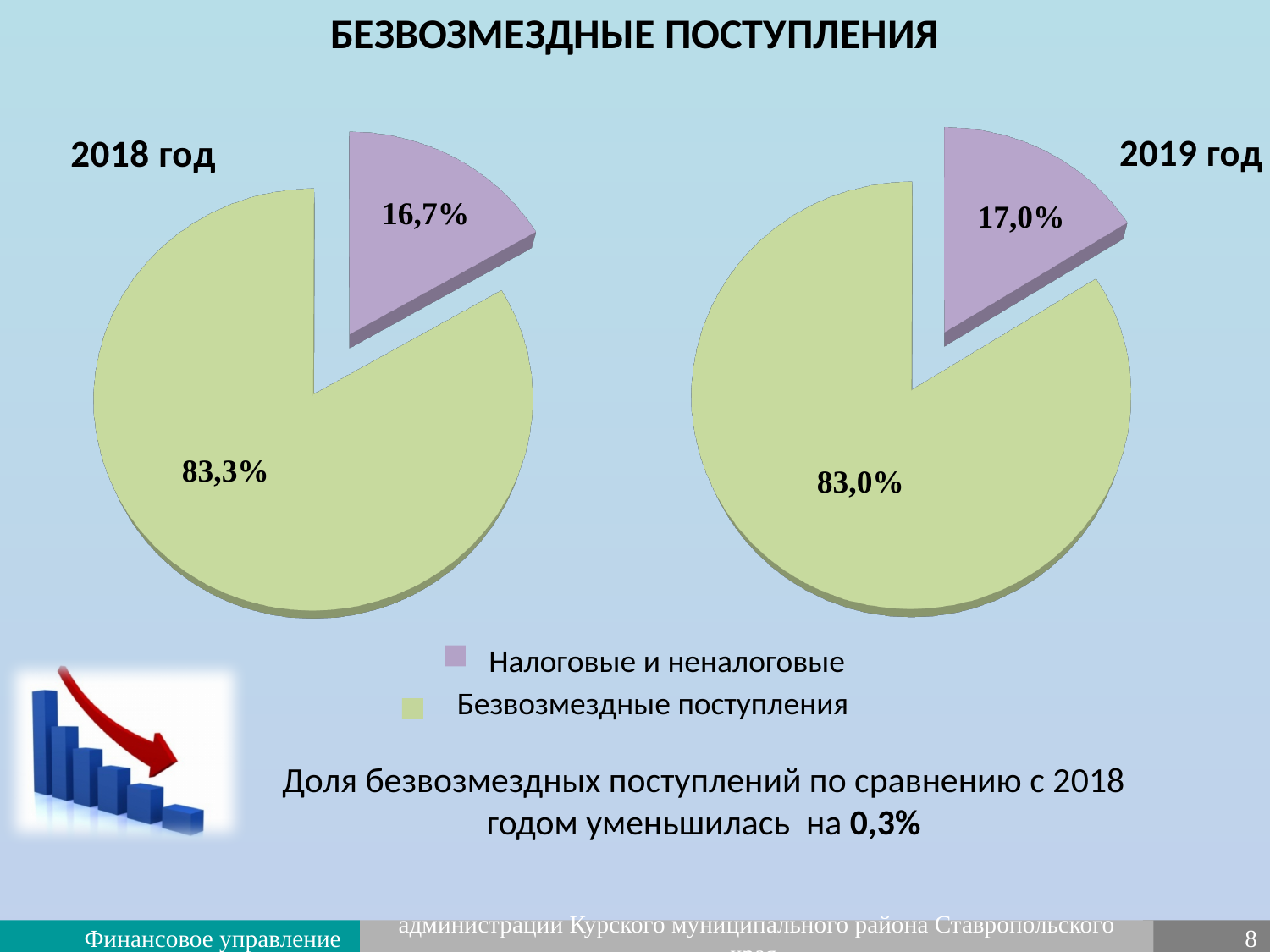
How many slices does the 2018 год pie chart have? 2 What colour represents Безвозмездные поступления in the pie charts? Light green In the 2019 год pie chart, what share is shown for Налоговые и неналоговые? 17,0% In the 2019 год pie chart, which category has the largest slice? Безвозмездные поступления Is the Налоговые и неналоговые share larger in the 2018 год chart or the 2019 год chart? 2019 год What is the difference between the Безвозмездные поступления share in the 2018 год chart and in the 2019 год chart? 0,3% In the 2018 год pie chart, which category has the smallest slice? Налоговые и неналоговые In the 2018 год pie chart, what share is shown for Безвозмездные поступления? 83,3% In the 2018 год pie chart, what share is shown for Налоговые и неналоговые? 16,7% In the 2019 год pie chart, what share is shown for Безвозмездные поступления? 83,0% How many entries does the legend list? 2 What type of chart is used for the 2019 год data? Pie chart